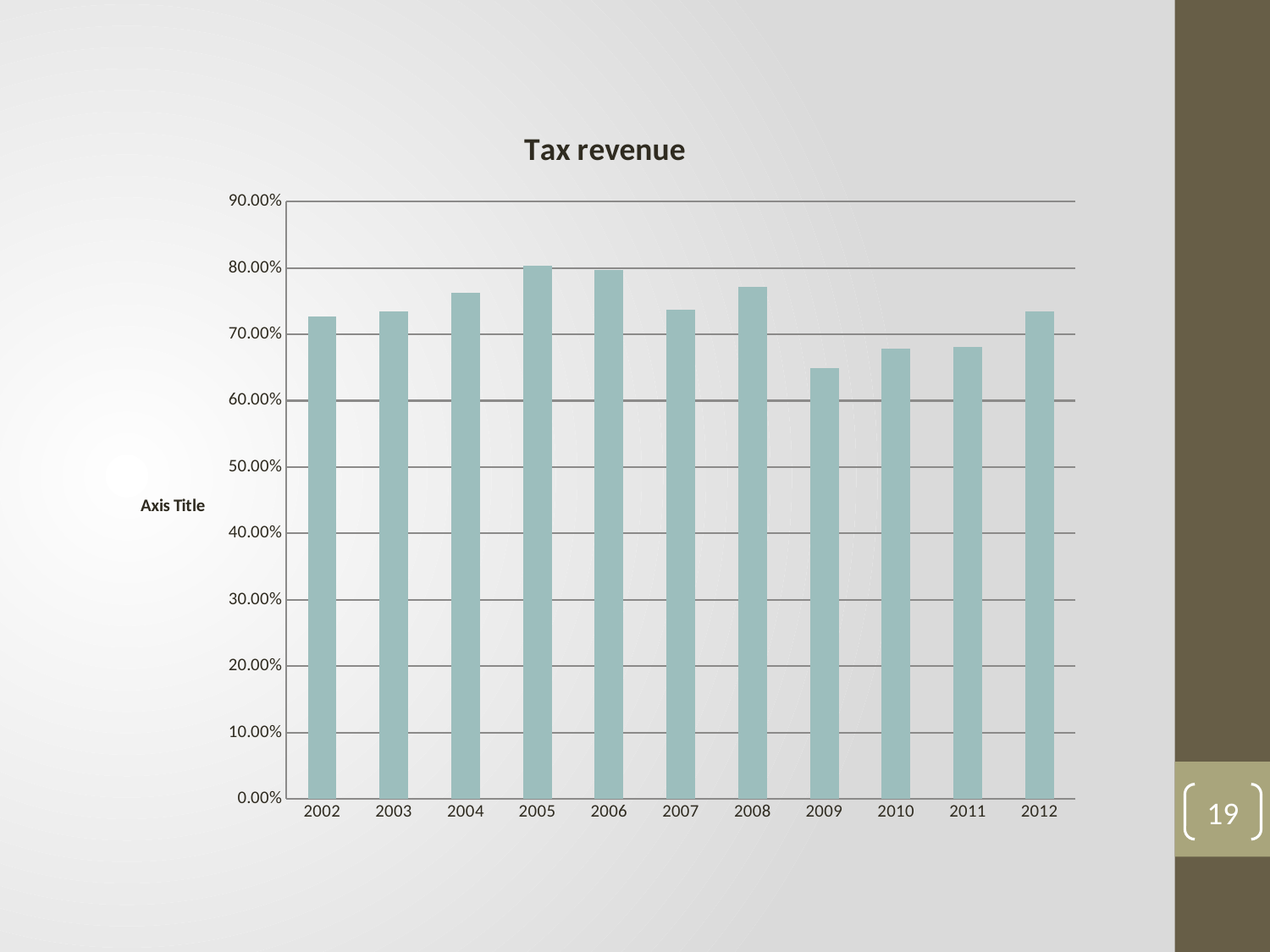
Is the value for 2008 greater or less than 80.00%? less How many years are shown on the x axis of the chart? 11 Is the value for 2002 greater or less than 70.00%? greater What is the title of the chart? Tax revenue Which year has the lowest tax revenue value? 2009 Do the values rise or fall from 2008 to 2009? fall Is the value for 2009 greater or less than 70.00%? less Which is larger, the value for 2004 or the value for 2009? 2004 What kind of chart is shown on the slide? bar chart Which is larger, the value for 2008 or the value for 2011? 2008